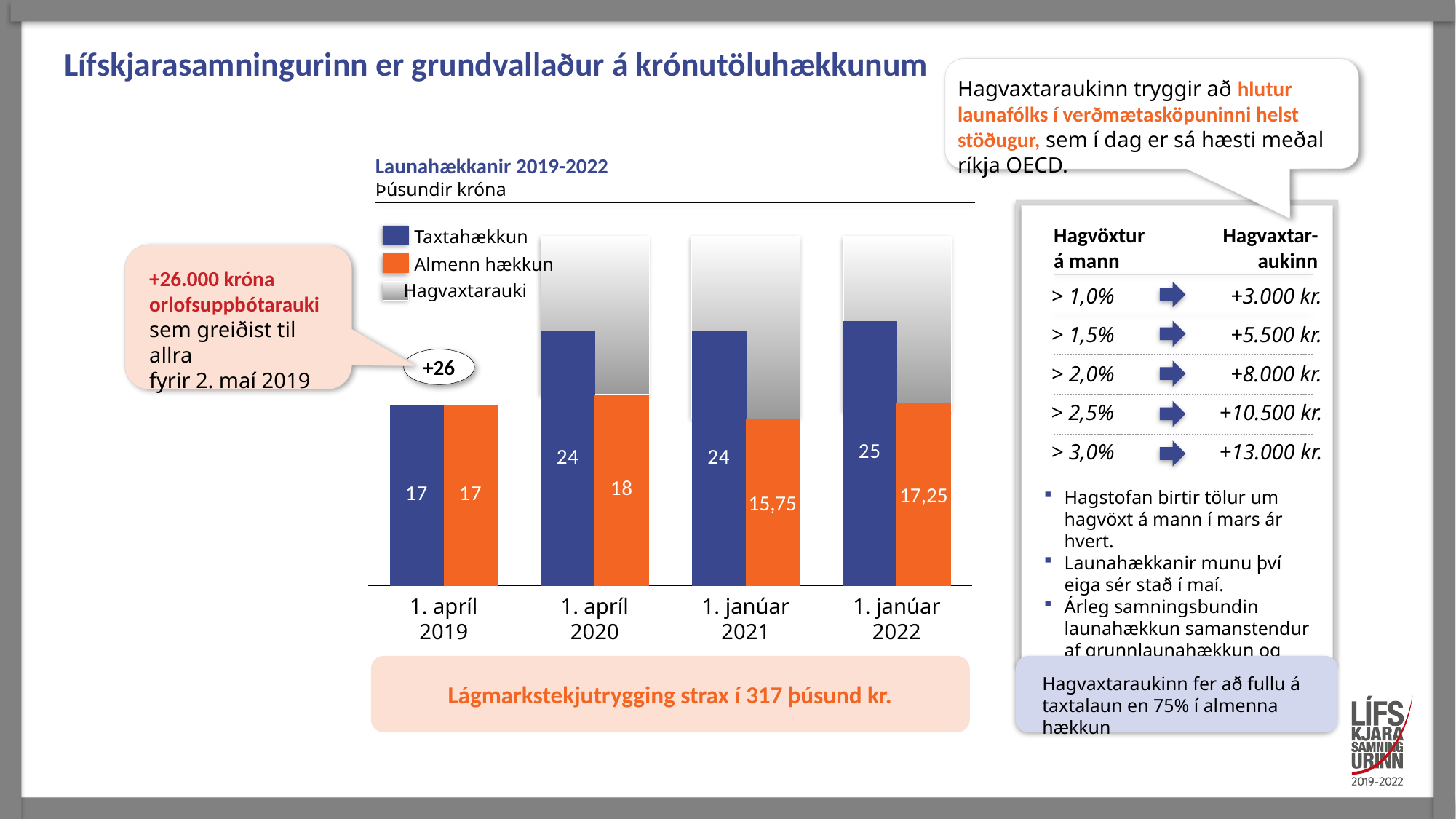
Which is larger for 1. apríl 2020: Taxtahækkun or Almenn hækkun? Taxtahækkun How many time periods are shown on the x axis of the chart? 4 What is the Almenn hækkun value for 1. janúar 2022? 17,25 What kind of chart is shown on the slide? Bar chart What is the Taxtahækkun value for 1. apríl 2020? 24 What is the Almenn hækkun value for 1. janúar 2021? 15,75 In which period is the Almenn hækkun value lowest? 1. janúar 2021 How many series does the chart legend list? 3 Does the Taxtahækkun value rise or fall from 1. apríl 2019 to 1. janúar 2022? Rise What is the difference between the Taxtahækkun and Almenn hækkun values for 1. janúar 2021? 8,25 What unit is stated under the chart title? Þúsundir króna In which period is the Taxtahækkun value highest? 1. janúar 2022